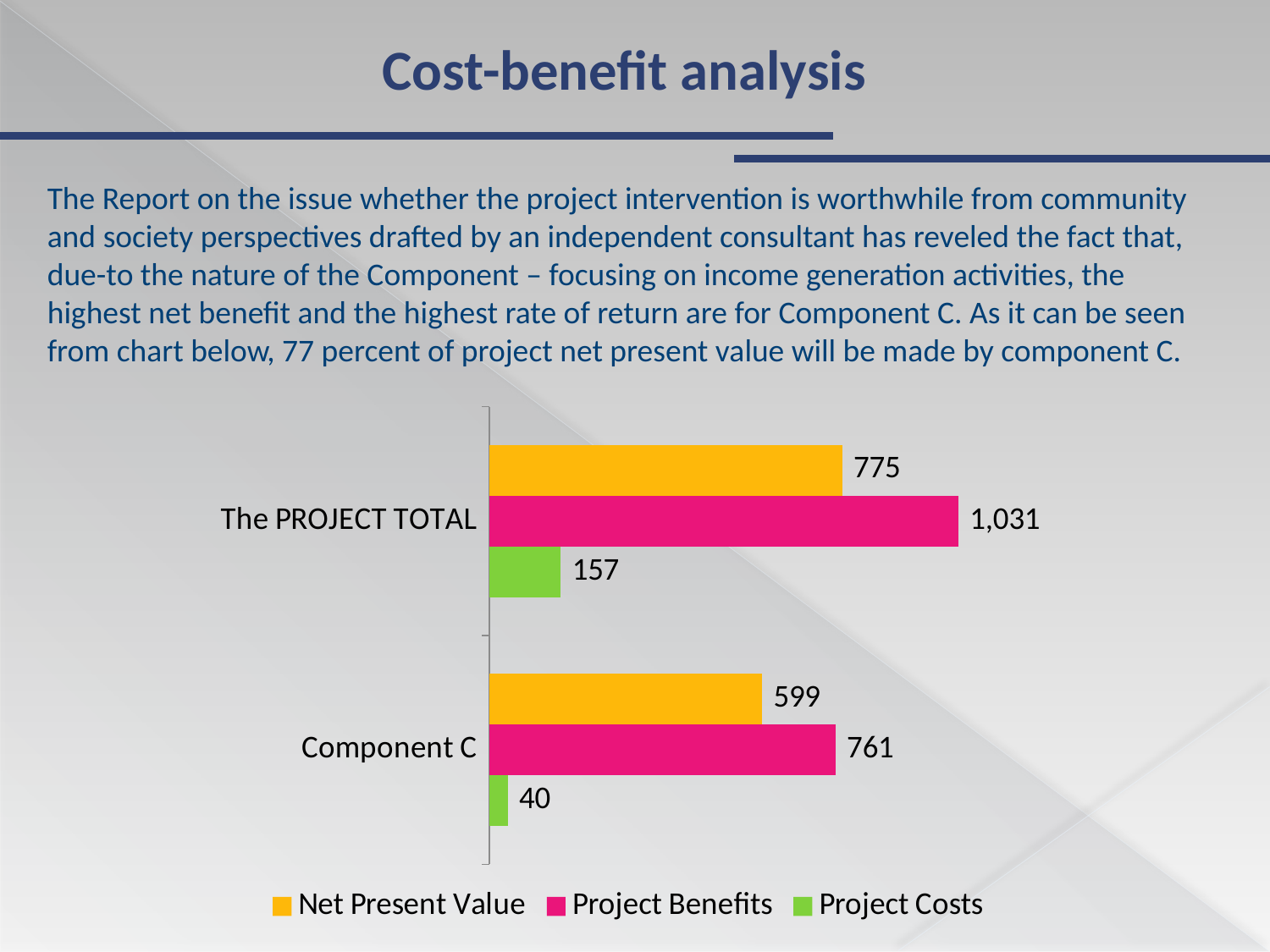
What is the Project Costs value for The PROJECT TOTAL? 157 What is the Project Costs value for Component C? 40 How many series does the legend list? 3 What is the difference between Project Benefits and Project Costs for Component C? 721 Which series has the lowest value for Component C? Project Costs What is the Project Benefits value for The PROJECT TOTAL? 1,031 Which series has the highest value for The PROJECT TOTAL? Project Benefits What is the Net Present Value for Component C? 599 What is the difference between the Net Present Value for The PROJECT TOTAL and for Component C? 176 Which is larger: the Project Benefits for Component C or the Net Present Value for The PROJECT TOTAL? Net Present Value for The PROJECT TOTAL How many categories are shown on the chart? 2 What kind of chart is shown on the slide? Bar chart